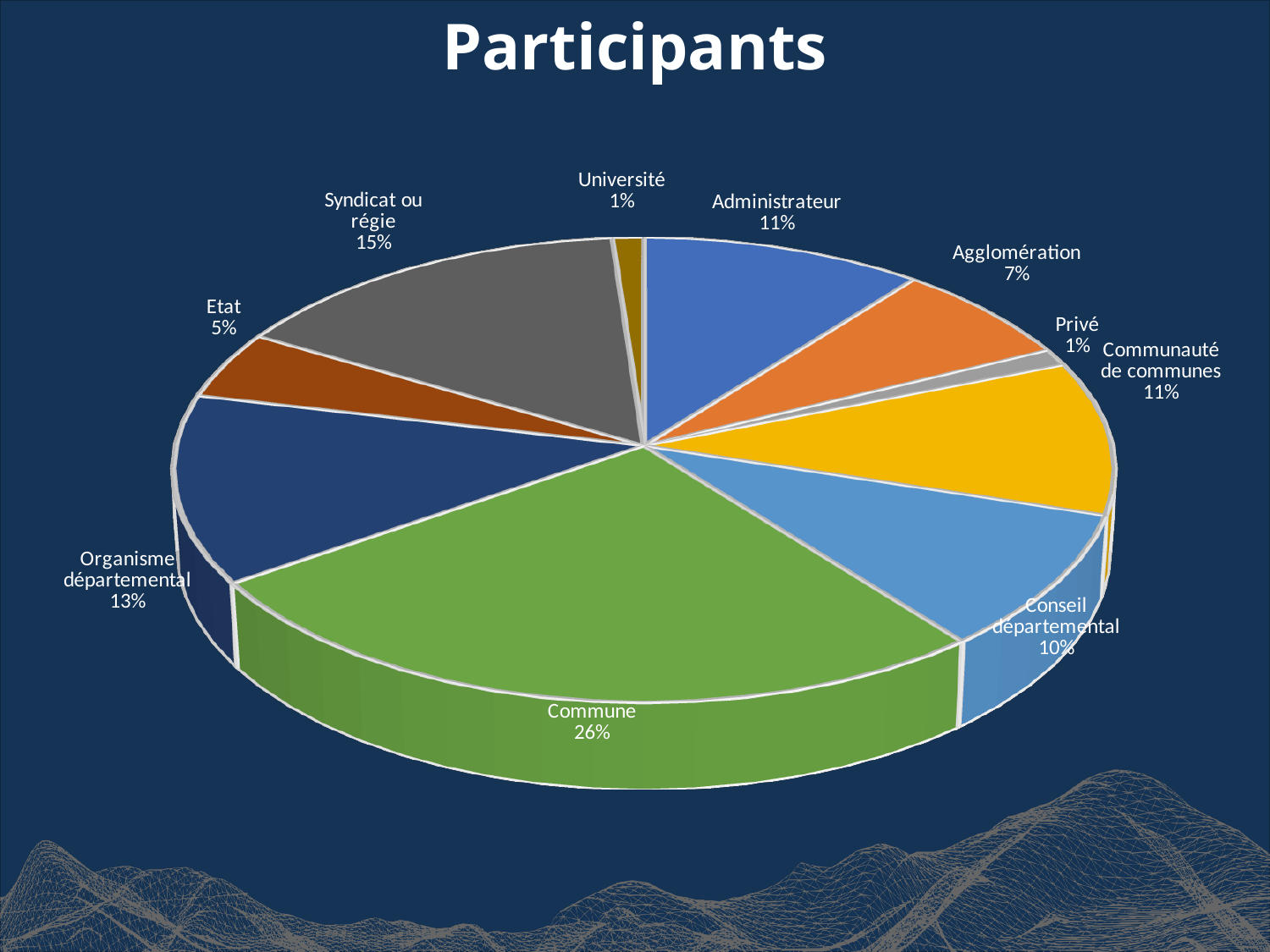
How many categories are shown in the pie chart? 10 What share of participants is Agglomération? 7% What kind of chart is shown on the slide? pie chart What is the title of the chart? Participants What share of participants is Organisme départemental? 13% Which category has the largest share of the pie? Commune Which is larger, the share for Organisme départemental or the share for Conseil départemental? Organisme départemental What share of participants is Syndicat ou régie? 15% What share of participants is Etat? 5% What share of participants is Commune? 26% What is the difference in percentage points between Commune and Syndicat ou régie? 11 What is the difference in percentage points between Administrateur and Agglomération? 4